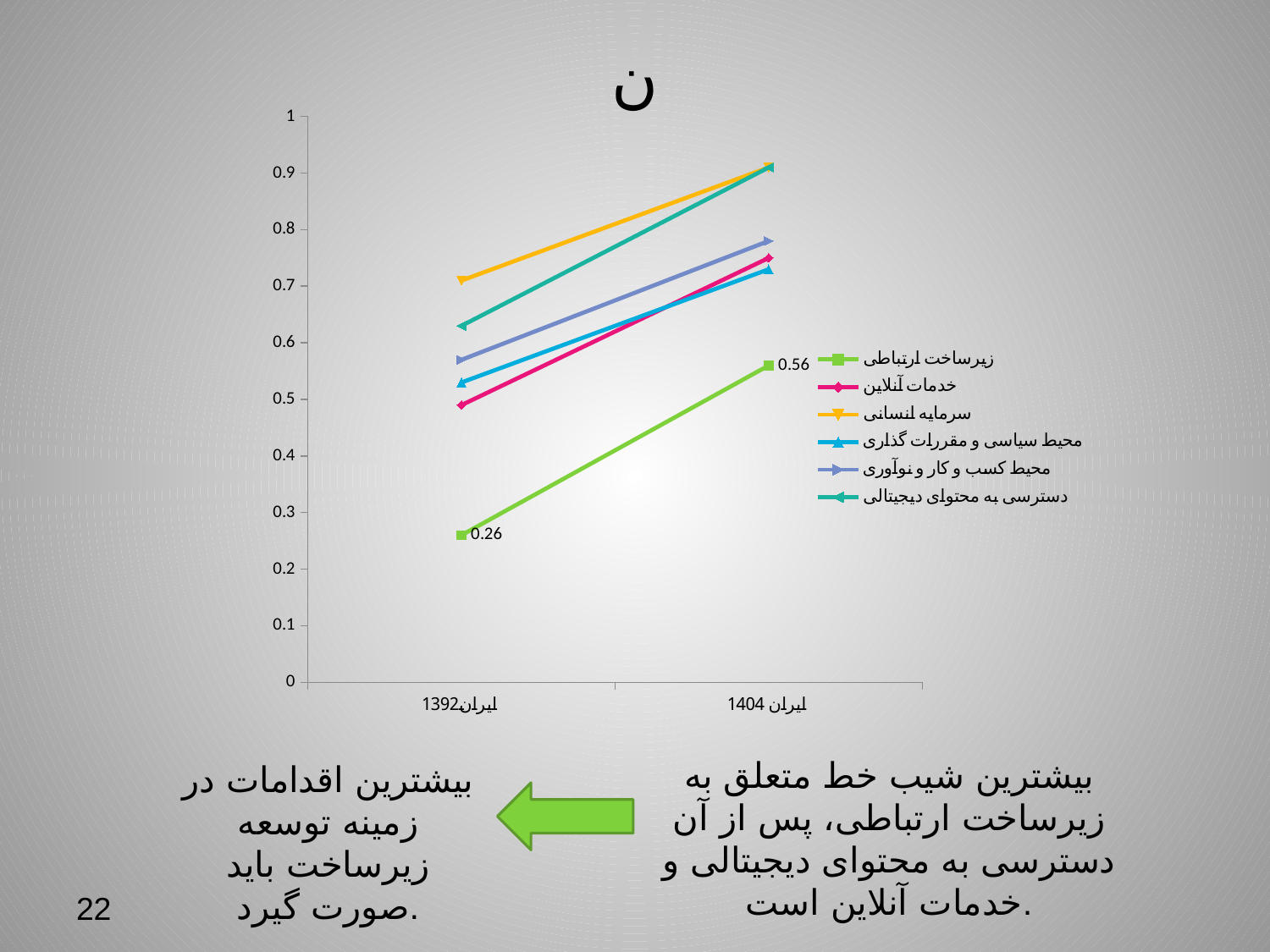
At ایران 1392, which is larger: the value for سرمایه انسانی or the value for خدمات آنلاین? سرمایه انسانی Is the value for محیط کسب و کار و نوآوری at ایران 1404 greater or less than 0.7? greater What colour is the line for زیرساخت ارتباطی? Green By how much does the value for زیرساخت ارتباطی increase from ایران 1392 to ایران 1404? 0.30 How many series does the legend list? 6 What kind of chart is shown on the slide? Line chart Which series has the lowest value at ایران 1392? زیرساخت ارتباطی What is the value for زیرساخت ارتباطی at ایران 1392? 0.26 Which series has the highest value at ایران 1392? سرمایه انسانی How many categories are shown on the x axis? 2 Do the values for زیرساخت ارتباطی rise or fall from ایران 1392 to ایران 1404? Rise What is the value for زیرساخت ارتباطی at ایران 1404? 0.56